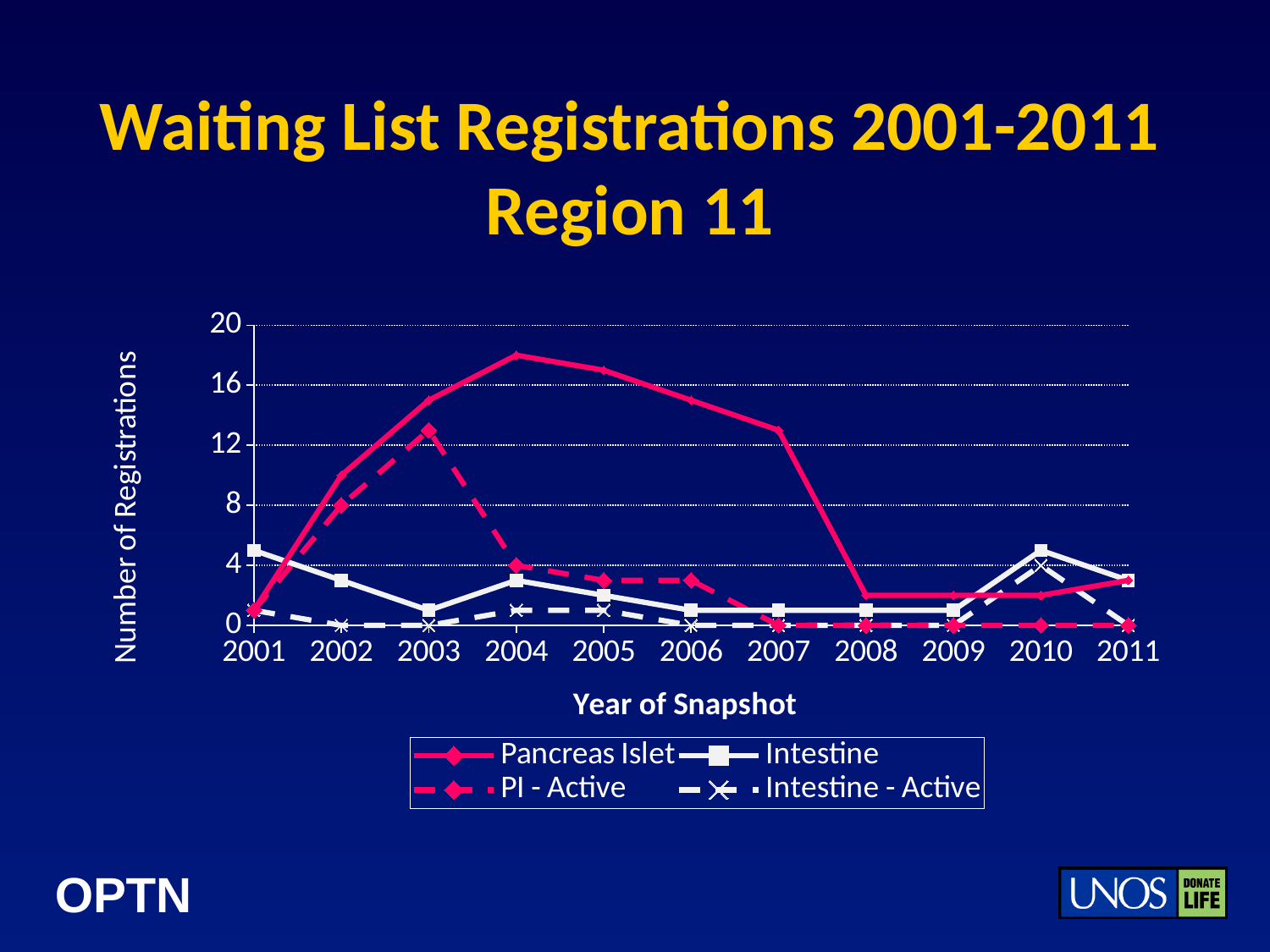
Is the value for Pancreas Islet in 2004 greater or less than 16? greater What kind of chart is shown on the slide? line chart What is the label of the y axis? Number of Registrations What is the value for PI - Active in 2011? 0 How many years are shown on the x axis? 11 Which series has the larger value in 2005, Pancreas Islet or Intestine? Pancreas Islet Is the value for Pancreas Islet in 2008 greater or less than 4? less How many series does the legend list? 4 Does the Pancreas Islet series rise or fall from 2004 to 2008? fall Is the value for PI - Active in 2003 greater or less than 12? greater What is the label of the x axis? Year of Snapshot In which year does the Pancreas Islet series reach its highest value? 2004